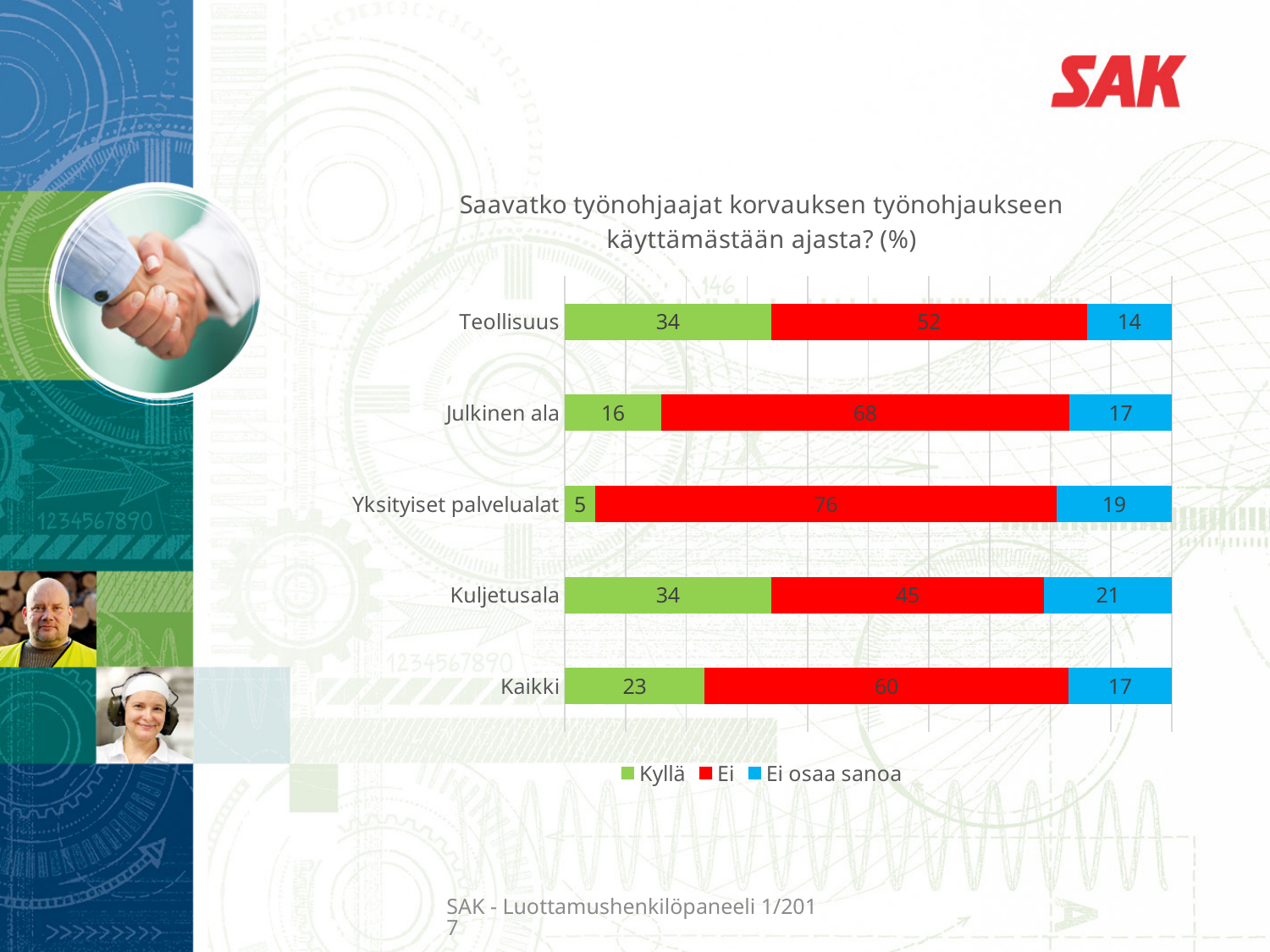
What is the total of the stacked bar for Kuljetusala? 100 How many series does the legend list? 3 What is the "Ei" value for Kaikki? 60 What is the "Ei osaa sanoa" value for Kuljetusala? 21 What is the "Kyllä" value for Teollisuus? 34 What kind of chart is shown on the slide? Stacked bar chart Which category has the highest "Ei" value? Yksityiset palvelualat What is the difference between the "Ei" values for Julkinen ala and Teollisuus? 16 How many categories are shown on the chart? 5 Which category has the lowest "Kyllä" value? Yksityiset palvelualat Which is larger, the "Ei osaa sanoa" value for Kuljetusala or for Teollisuus? Kuljetusala What is the "Ei" value for Yksityiset palvelualat? 76